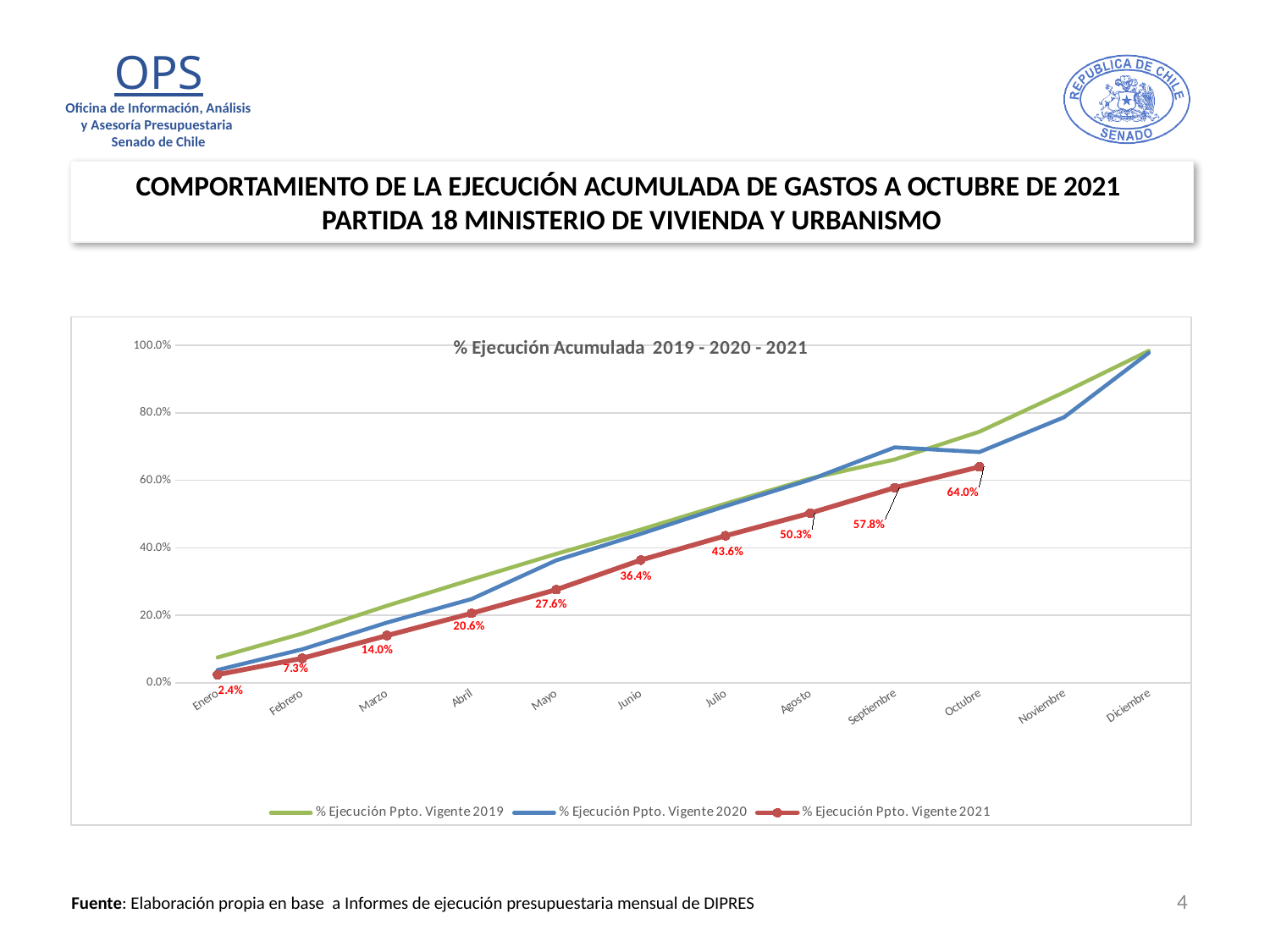
Do the values of the % Ejecución Ppto. Vigente 2021 series rise or fall from Enero to Octubre? Rise What is the difference between the Abril and Marzo values in the % Ejecución Ppto. Vigente 2021 series? 6.6% What is the value for Enero in the % Ejecución Ppto. Vigente 2021 series? 2.4% How many months are shown on the x axis? 12 What is the value for Junio in the % Ejecución Ppto. Vigente 2021 series? 36.4% Which month has the highest labelled value in the % Ejecución Ppto. Vigente 2021 series? Octubre What is the difference between the Octubre and Septiembre values in the % Ejecución Ppto. Vigente 2021 series? 6.2% What kind of chart is shown on the slide? Line chart Which month has the lowest value in the % Ejecución Ppto. Vigente 2021 series? Enero How many series does the legend list? 3 Is the value for Diciembre in the % Ejecución Ppto. Vigente 2019 series greater or less than 80.0%? greater What is the value for Octubre in the % Ejecución Ppto. Vigente 2021 series? 64.0%